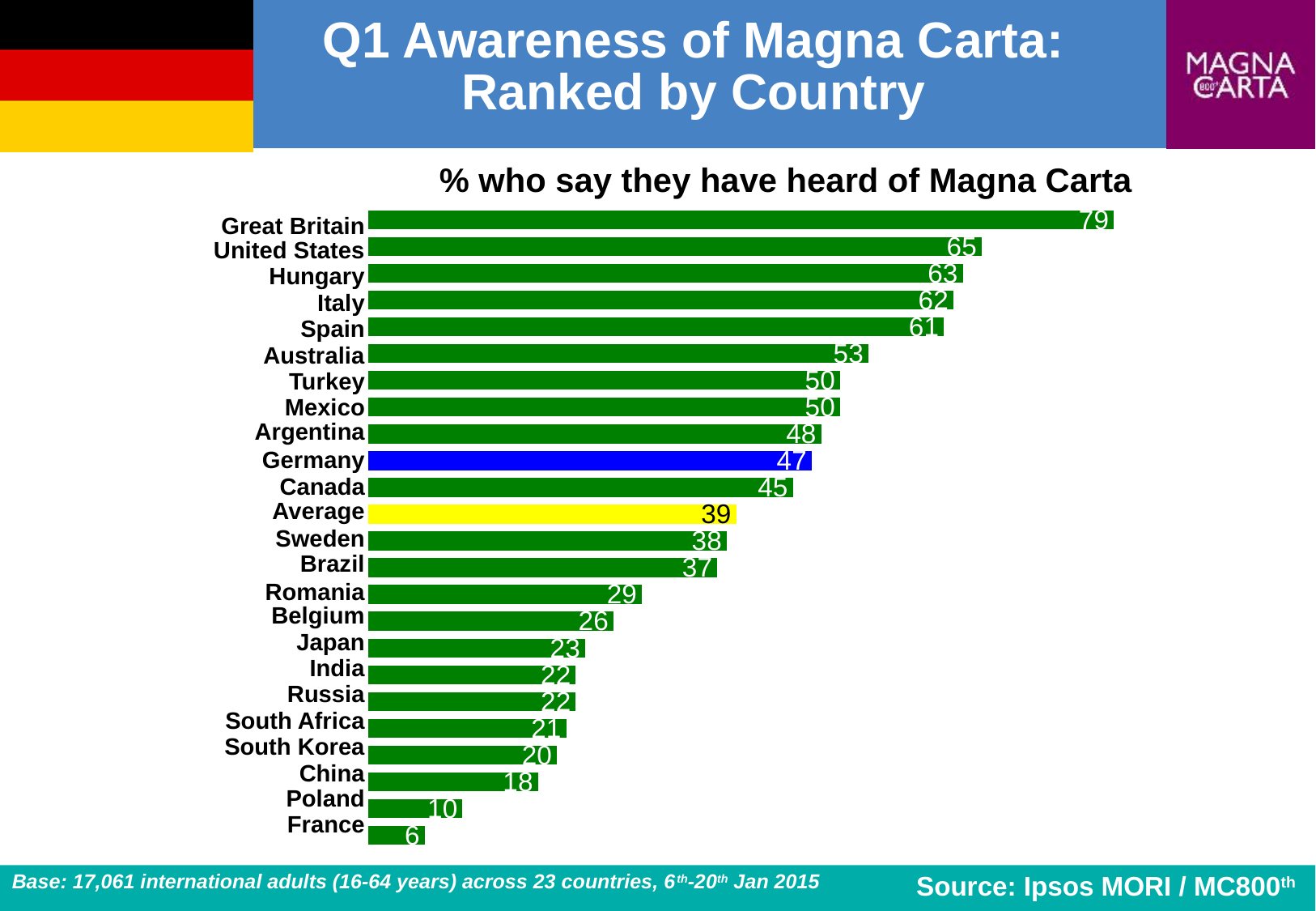
Which has a higher value, Romania or Japan? Romania Which has a higher value, Canada or Sweden? Canada How many bars are plotted on the chart, including the Average bar? 24 What is the Average value shown on the chart? 39 Which country has the highest percentage who say they have heard of Magna Carta? Great Britain How much higher is Germany's value than the Average? 8 What is the difference between the values for Great Britain and the United States? 14 What percentage of people in Germany say they have heard of Magna Carta? 47 What kind of chart is shown on the slide? Bar chart What is the value shown for Hungary? 63 Which bar on the chart is coloured yellow? Average Which country has the lowest percentage who say they have heard of Magna Carta? France